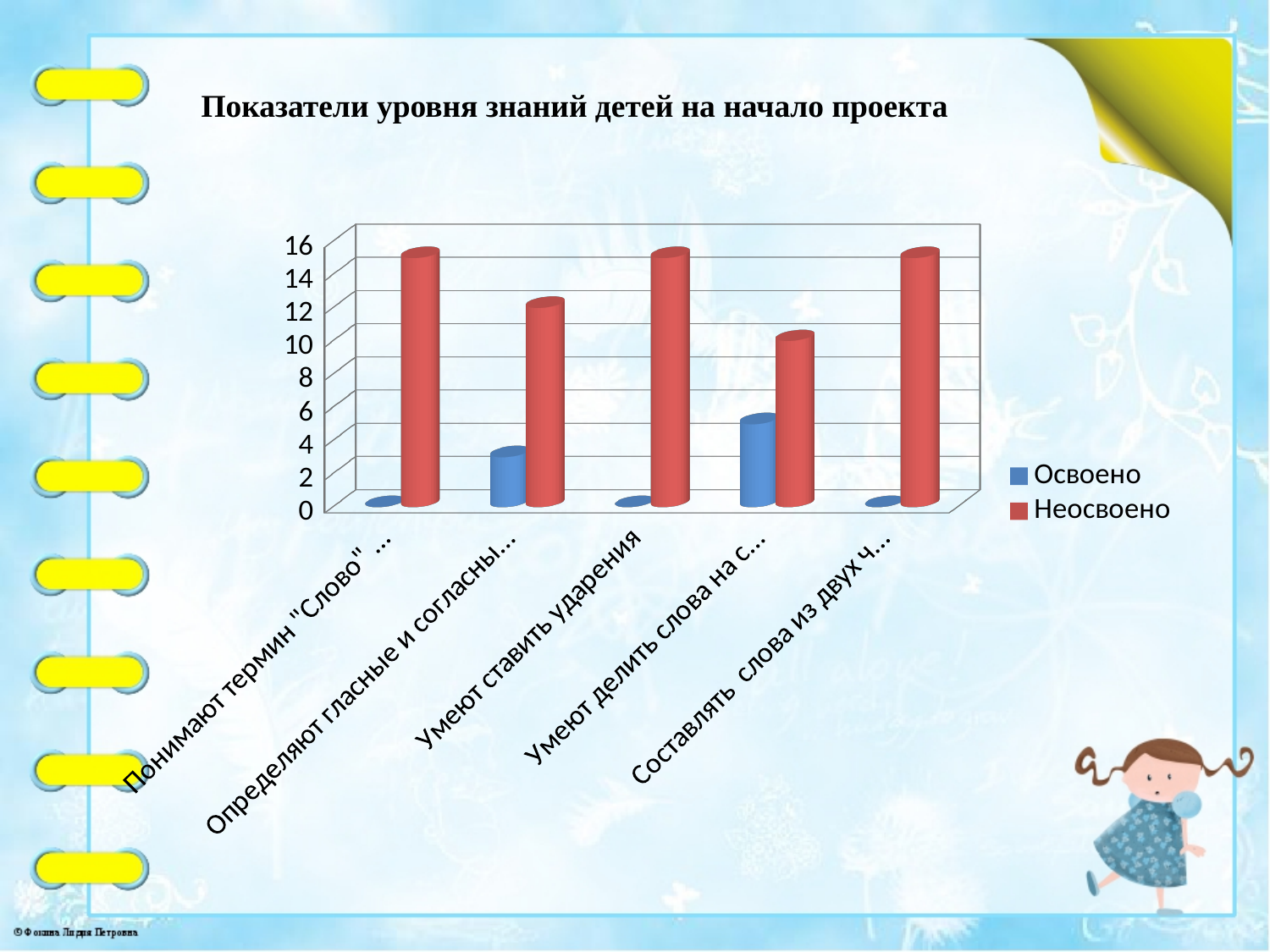
Is the Неосвоено value for "Умеют ставить ударения" greater or less than 12? greater For the category "Умеют ставить ударения", which series has the larger value, Освоено or Неосвоено? Неосвоено For which category is the Неосвоено value lowest? Умеют делить слова на с... How many series does the legend list? 2 Is the Освоено value for "Умеют делить слова на с..." greater or less than 2? greater Is the Освоено value for "Определяют гласные и согласны..." greater or less than 6? less What is the title of the chart? Показатели уровня знаний детей на начало проекта What kind of chart is shown on the slide? Bar chart What are the two series named in the legend? Освоено and Неосвоено How many categories are shown on the x axis? 5 For which category is the Освоено value highest? Умеют делить слова на с...